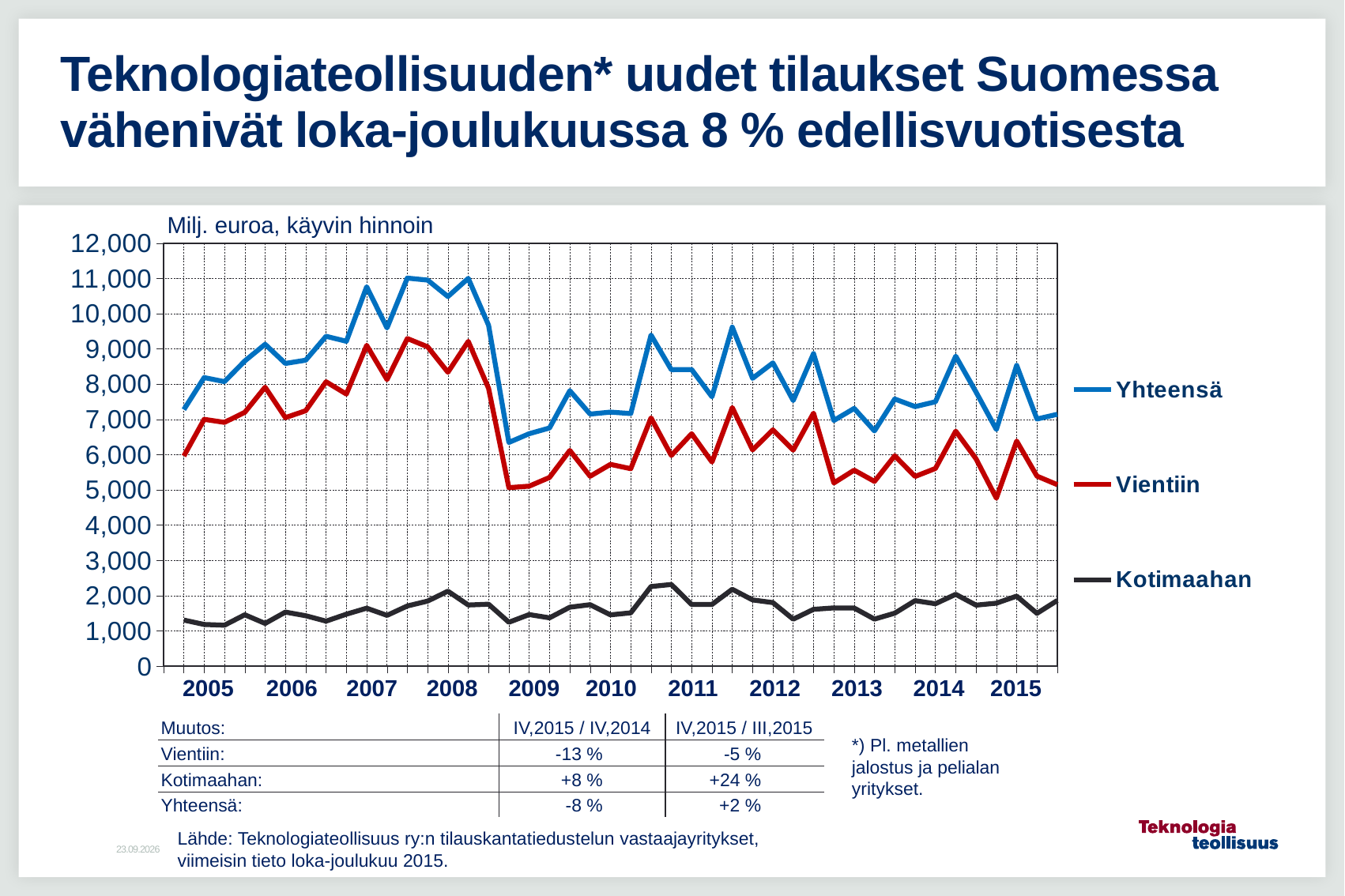
Which series has the lowest values throughout the chart? Kotimaahan Is the peak value of the Yhteensä series around 2007–2008 greater or less than 10,000? greater What unit label is shown above the chart's y axis? Milj. euroa, käyvin hinnoin What kind of chart is shown on the slide? line chart Which series is larger in 2012, Vientiin or Kotimaahan? Vientiin Is the value of the Vientiin series at the start of 2009 greater or less than 6,000? less What colour is the Vientiin line in the chart? red How many years are labelled on the x axis of the chart? 11 Which series has the highest values throughout the chart? Yhteensä Is the Kotimaahan series ever greater or less than 3,000 over the whole period? less How many series does the chart's legend list? 3 Does the Yhteensä series rise or fall between 2008 and 2009? fall